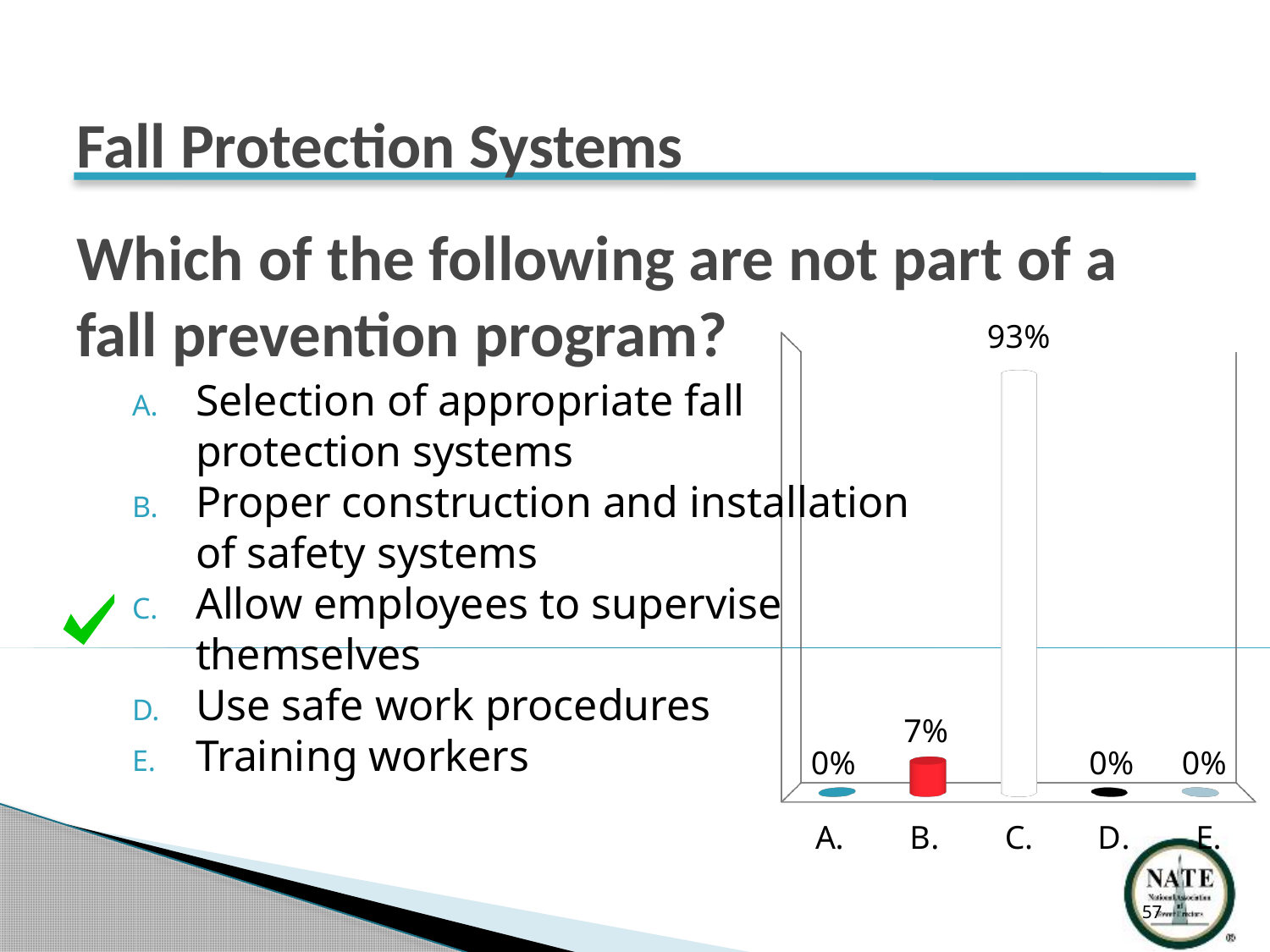
Which category has the highest value in the chart? C. What is the value for category B. in the chart? 7% What is the value for category E. in the chart? 0% Which is larger in the chart, the value for B. or the value for C.? C. What kind of chart is shown on the slide? bar chart How many categories are shown on the x axis of the chart? 5 What is the value for category C. in the chart? 93% What is the value for category D. in the chart? 0% What colour is the bar for category B. in the chart? red What is the difference between the values for C. and B. in the chart? 86% How many categories in the chart have a value of 0%? 3 What is the value for category A. in the chart? 0%